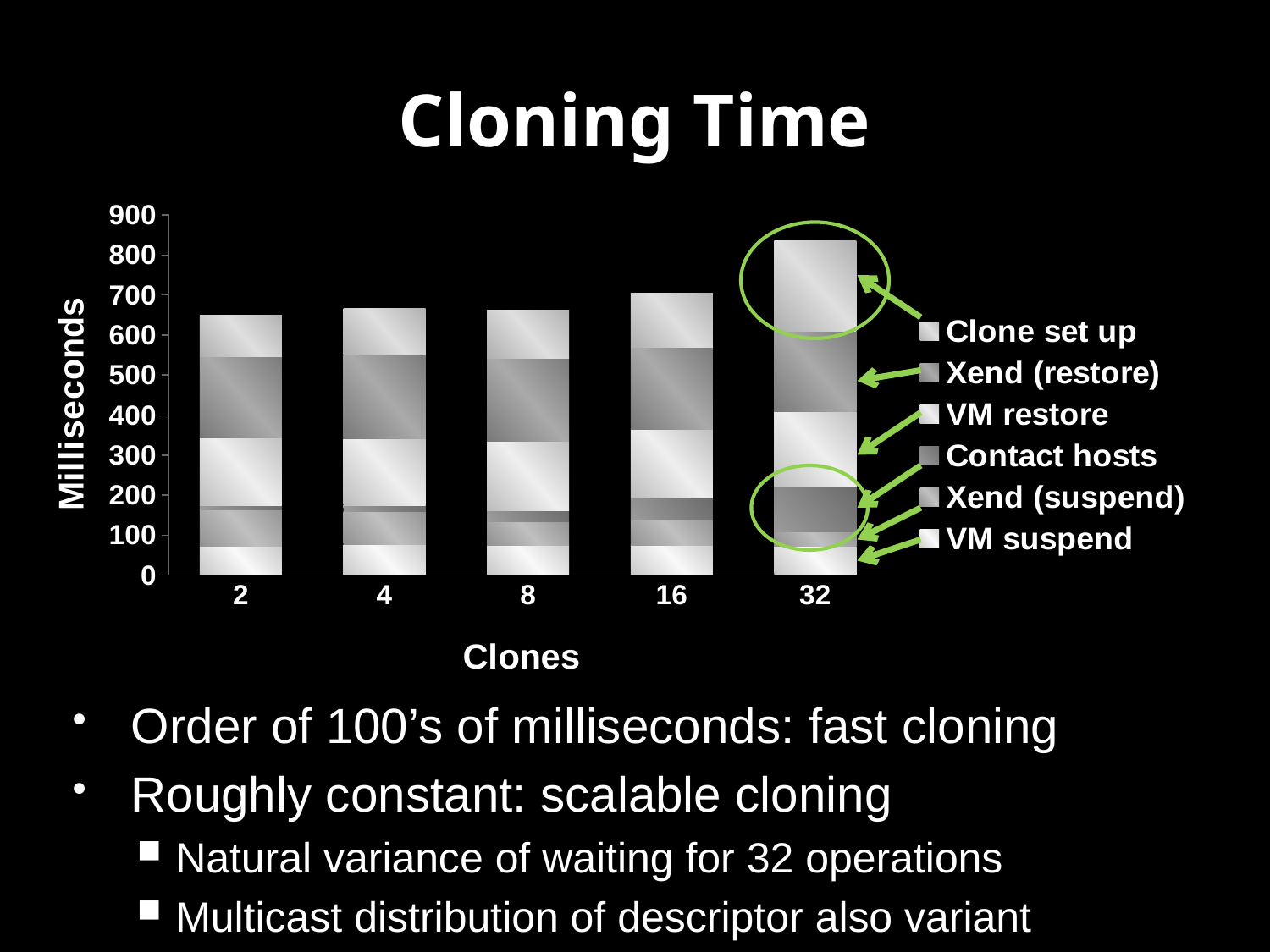
Which has a larger total cloning time, 2 clones or 32 clones? 32 clones How many clone counts (categories) are plotted on the x axis? 5 Is the total cloning time for 32 clones greater or less than 800 milliseconds? greater How many series does the legend list? 6 What kind of chart is shown on the slide? Stacked bar chart Is the total cloning time for 32 clones greater or less than 900 milliseconds? less Which clone count has the highest total cloning time? 32 Overall, do the total bar heights rise or fall as the number of clones increases from 2 to 32? rise What is the title of the chart? Cloning Time What is the label of the y axis? Milliseconds Is the total cloning time for 2 clones greater or less than 700 milliseconds? less